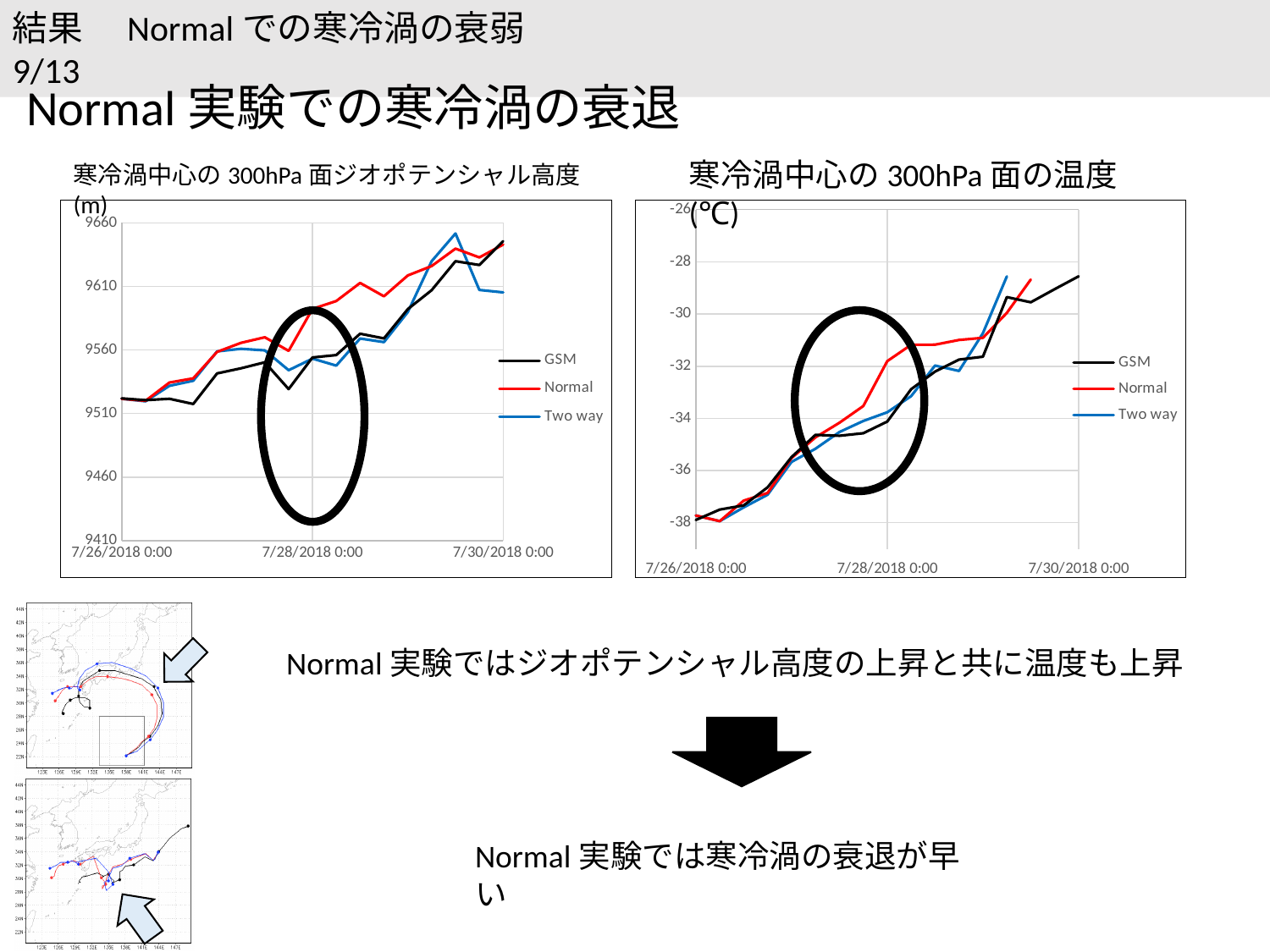
In the left chart (寒冷渦中心の 300hPa 面ジオポテンシャル高度), do the values of the Normal series rise or fall from 7/26/2018 0:00 to 7/30/2018 0:00? rise In the right chart (寒冷渦中心の 300hPa 面の温度), do the values of the GSM series rise or fall over the period shown? rise In the right chart (寒冷渦中心の 300hPa 面の温度), which series has the highest value at 7/28/2018 0:00? Normal In the left chart (寒冷渦中心の 300hPa 面ジオポテンシャル高度), what are the three series named in the legend? GSM, Normal, Two way In the left chart (寒冷渦中心の 300hPa 面ジオポテンシャル高度), at 7/28/2018 0:00, which is larger: the Normal series or the GSM series? Normal In the right chart (寒冷渦中心の 300hPa 面の温度), is the value of the GSM series at 7/30/2018 0:00 greater or less than -30? greater In the left chart (寒冷渦中心の 300hPa 面ジオポテンシャル高度), is the value of the GSM series at 7/28/2018 0:00 greater or less than 9560? less What kind of chart is the left chart (寒冷渦中心の 300hPa 面ジオポテンシャル高度)? line chart In the right chart (寒冷渦中心の 300hPa 面の温度), is the value of the Normal series at 7/26/2018 0:00 greater or less than -36? less In the right chart (寒冷渦中心の 300hPa 面の温度), what unit is shown for the y axis? °C How many series does the legend of the right chart (寒冷渦中心の 300hPa 面の温度) list? 3